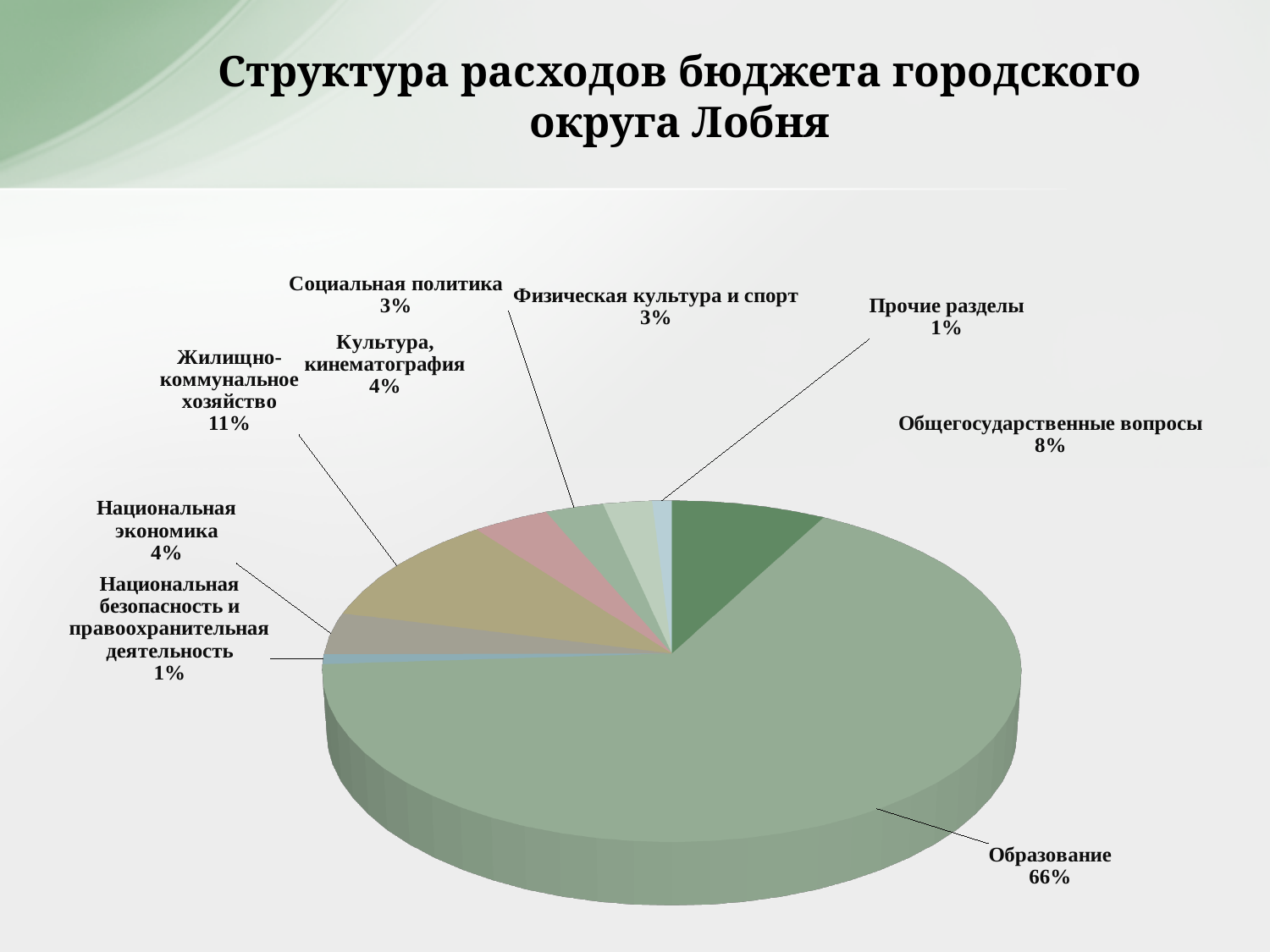
What is the difference in percentage points between Образование and Жилищно-коммунальное хозяйство? 55 What share of the budget expenditure goes to Жилищно-коммунальное хозяйство? 11% What is the title of the chart on the slide? Структура расходов бюджета городского округа Лобня What share of the budget expenditure goes to Образование? 66% What is the difference in percentage points between Жилищно-коммунальное хозяйство and Национальная экономика? 7 How many categories are shown in the pie chart? 9 Which category has the largest share of the budget expenditure? Образование Which has a larger share: Общегосударственные вопросы or Культура, кинематография? Общегосударственные вопросы What share of the budget expenditure goes to Общегосударственные вопросы? 8% What share of the budget expenditure goes to Прочие разделы? 1% What kind of chart is shown on the slide? pie chart What share of the budget expenditure goes to Социальная политика? 3%